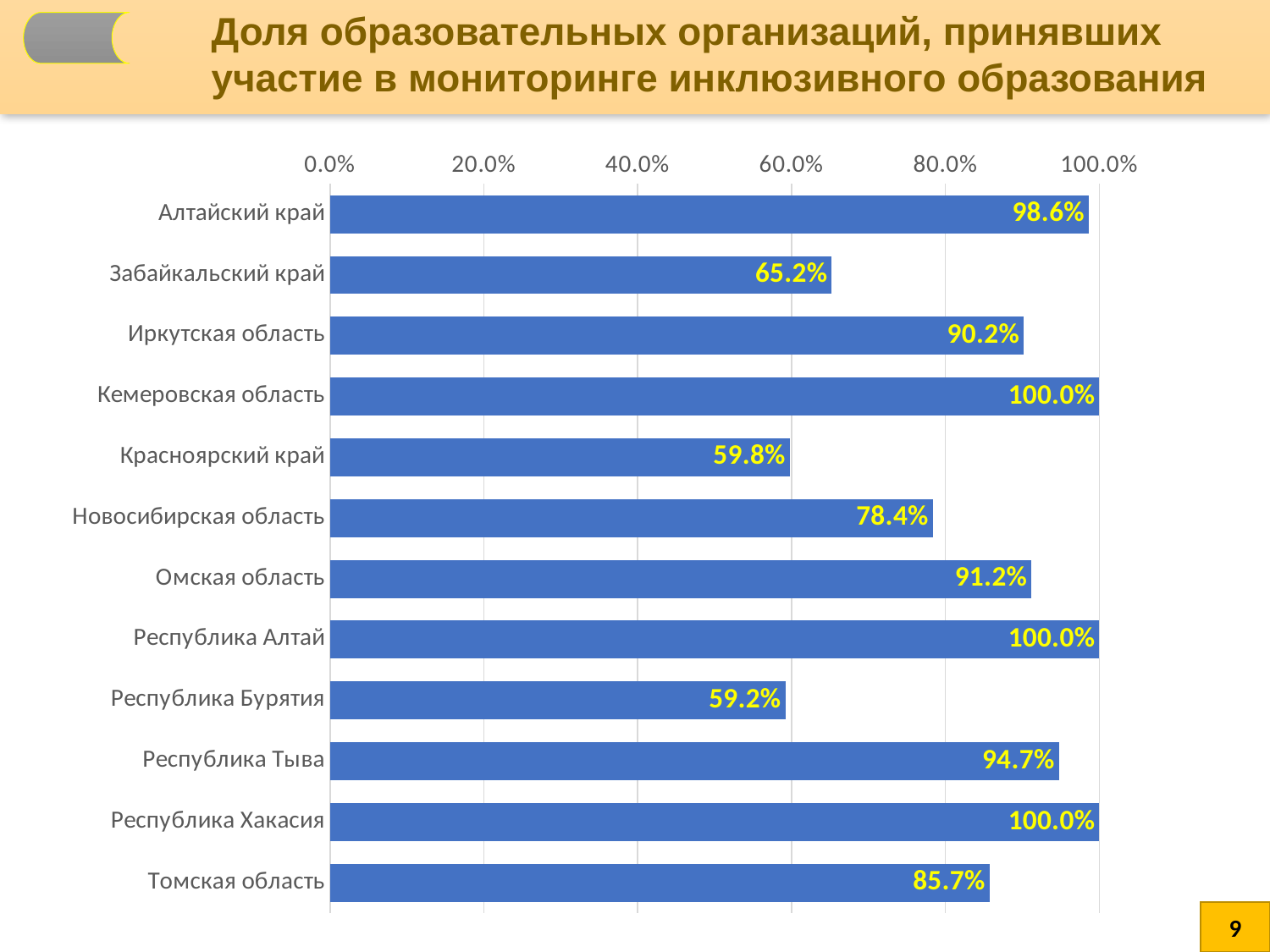
What kind of chart is shown on the slide? bar chart How many categories have a value of 100.0%? 3 What is the value for Алтайский край? 98.6% What is the value for Томская область? 85.7% What is the difference between the values for Иркутская область and Забайкальский край? 25.0% What is the title of the chart? Доля образовательных организаций, принявших участие в мониторинге инклюзивного образования How many categories are shown in the chart? 12 Is the value for Республика Тыва greater or less than 80.0%? greater What is the value for Красноярский край? 59.8% Which category has the lowest value? Республика Бурятия Which is larger, the value for Омская область or the value for Новосибирская область? Омская область What is the difference between the values for Кемеровская область and Республика Бурятия? 40.8%